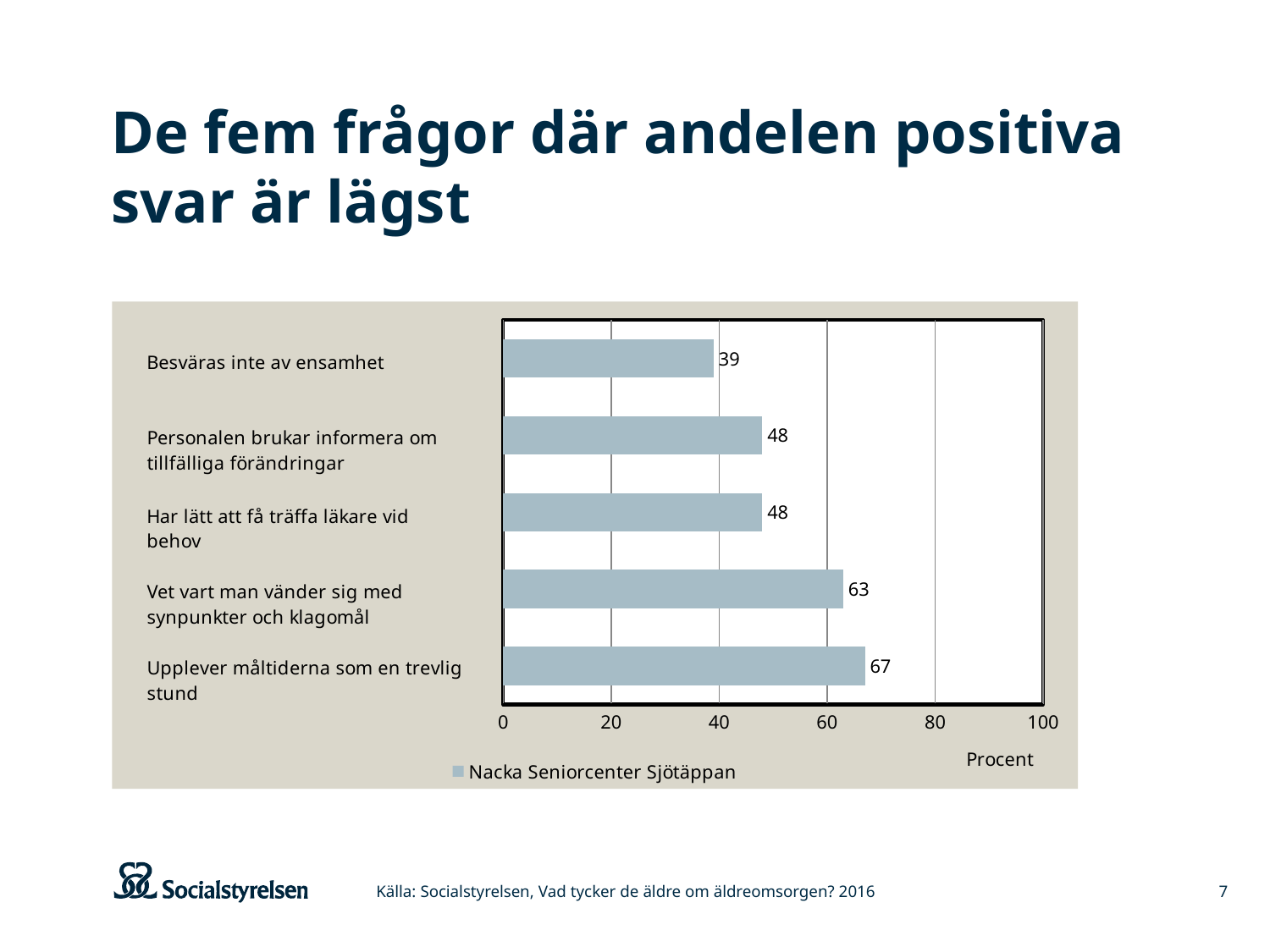
What kind of chart is shown on the slide? bar chart Which category has the highest value? Upplever måltiderna som en trevlig stund What is the value for "Besväras inte av ensamhet"? 39 What is the value for "Upplever måltiderna som en trevlig stund"? 67 Which is larger: the value for "Vet vart man vänder sig med synpunkter och klagomål" or for "Personalen brukar informera om tillfälliga förändringar"? Vet vart man vänder sig med synpunkter och klagomål What is the value for "Har lätt att få träffa läkare vid behov"? 48 What is the value for "Vet vart man vänder sig med synpunkter och klagomål"? 63 What series does the legend list? Nacka Seniorcenter Sjötäppan How many categories are shown in the chart? 5 Which category has the lowest value? Besväras inte av ensamhet Is the value for "Besväras inte av ensamhet" greater or less than 40? less What is the difference between the values for "Upplever måltiderna som en trevlig stund" and "Besväras inte av ensamhet"? 28